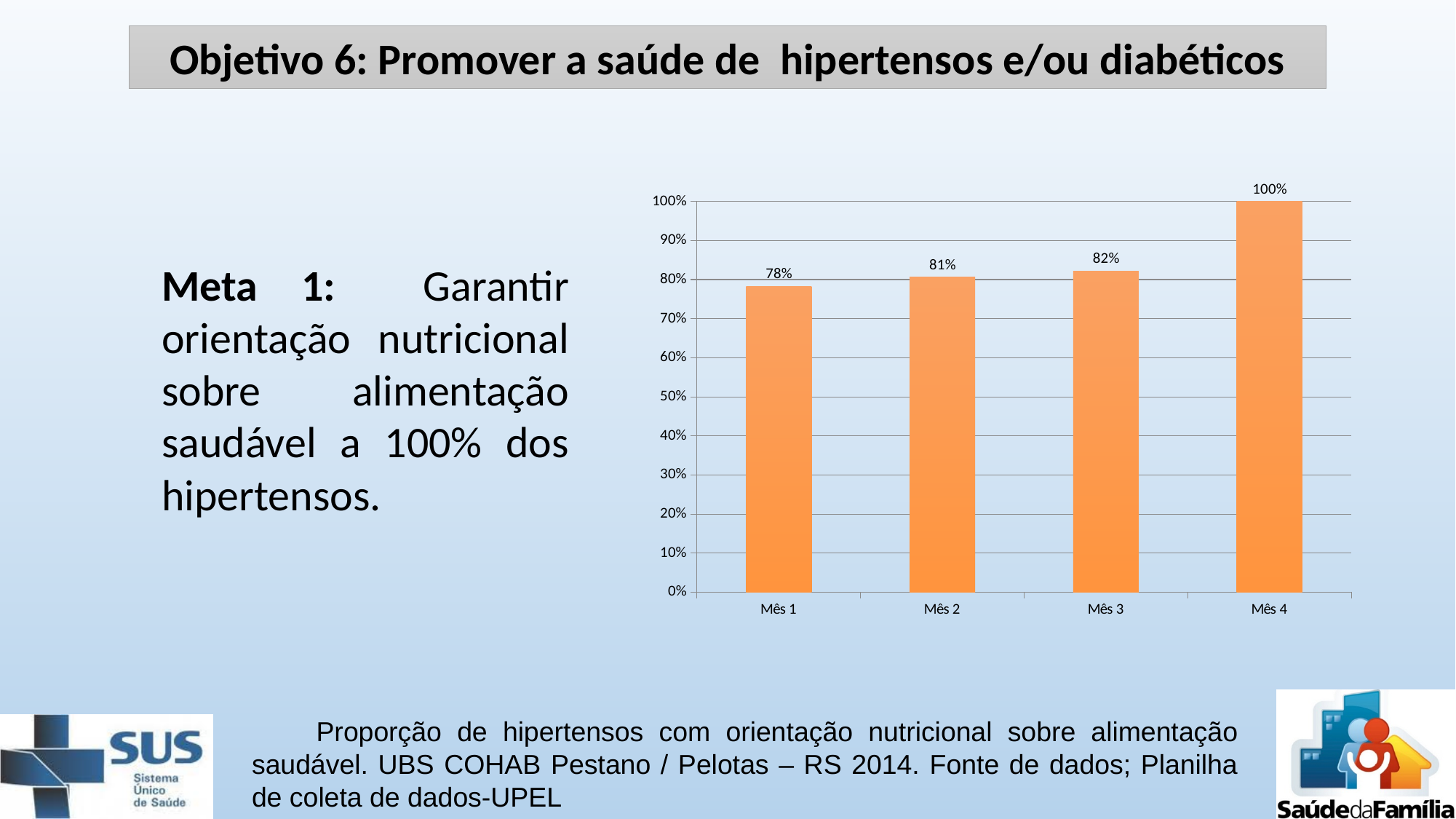
Which is larger, the value for Mês 2 or the value for Mês 4? Mês 4 Which month has the lowest value? Mês 1 What kind of chart is shown on the slide? Bar chart What is the value for Mês 3? 82% What is the value for Mês 1? 78% What is the value for Mês 4? 100% What is the value for Mês 2? 81% What is the difference between the values for Mês 4 and Mês 1? 22% What is the difference between the values for Mês 3 and Mês 2? 1% How many months are shown on the x axis of the chart? 4 Which month has the highest value? Mês 4 Do the values rise or fall from Mês 1 to Mês 4? Rise